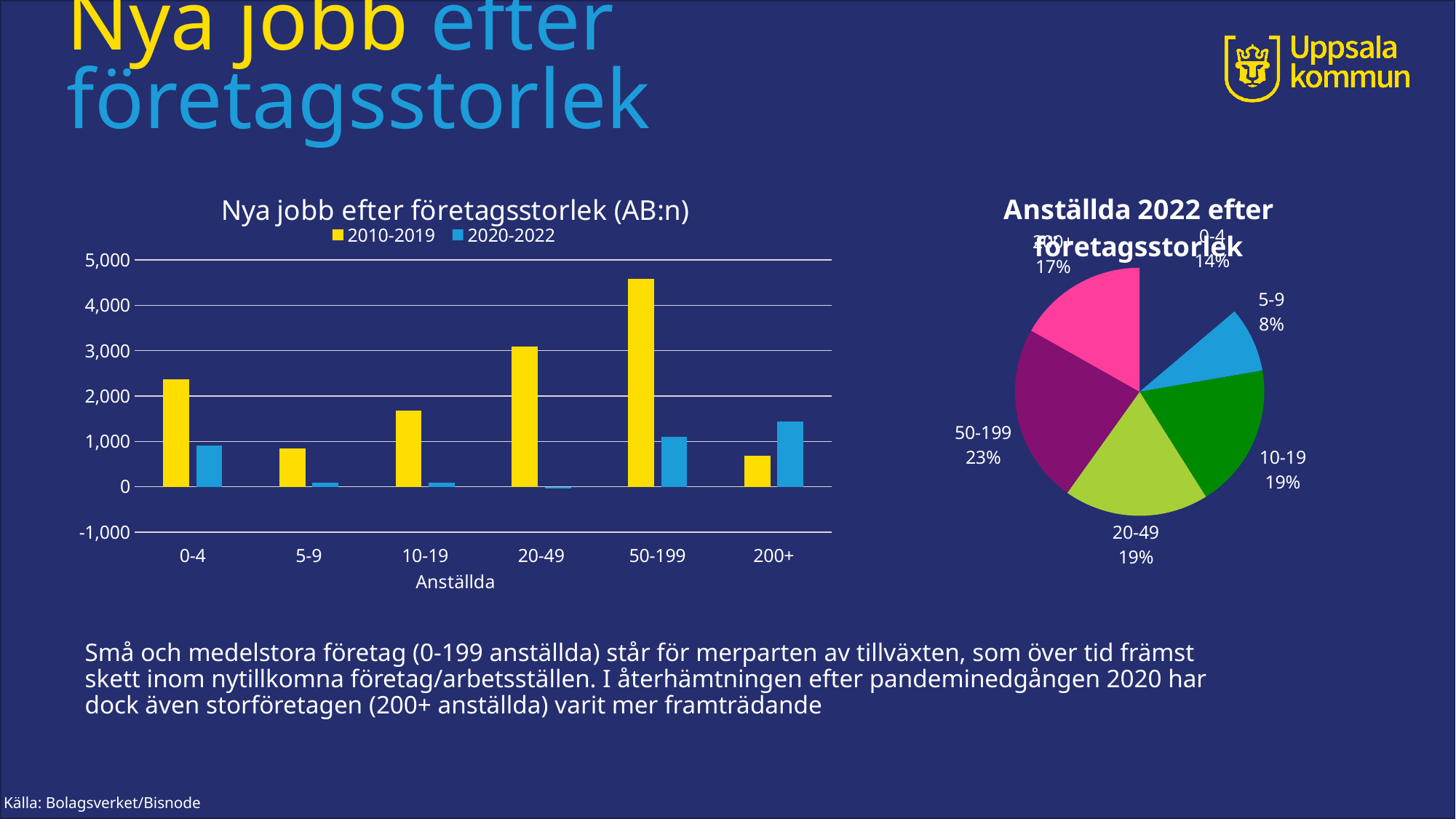
How many company-size categories are shown on the x axis of the 'Nya jobb efter företagsstorlek (AB:n)' chart? 6 In the 'Nya jobb efter företagsstorlek (AB:n)' chart, is the 2020-2022 value for 200+ greater or less than 1,000? greater What kind of chart is the chart titled 'Nya jobb efter företagsstorlek (AB:n)'? bar chart In the 'Nya jobb efter företagsstorlek (AB:n)' chart, which category has the highest value for 2020-2022? 200+ In the 'Nya jobb efter företagsstorlek (AB:n)' chart, which is larger for the 0-4 category: the 2010-2019 value or the 2020-2022 value? 2010-2019 In the 'Nya jobb efter företagsstorlek (AB:n)' chart, which category has the highest value for 2010-2019? 50-199 How many series does the legend of the 'Nya jobb efter företagsstorlek (AB:n)' chart list? 2 In the 'Nya jobb efter företagsstorlek (AB:n)' chart, is the 2010-2019 value for 50-199 greater or less than 4,000? greater In the pie chart 'Anställda 2022 efter företagsstorlek', what is the difference in percentage points between the 50-199 slice and the 5-9 slice? 15 percentage points In the pie chart 'Anställda 2022 efter företagsstorlek', which company size has the smallest share? 5-9 In the 'Nya jobb efter företagsstorlek (AB:n)' chart, is the 2010-2019 value for 5-9 greater or less than 1,000? less In the pie chart 'Anställda 2022 efter företagsstorlek', what share do companies with 50-199 employees have? 23%